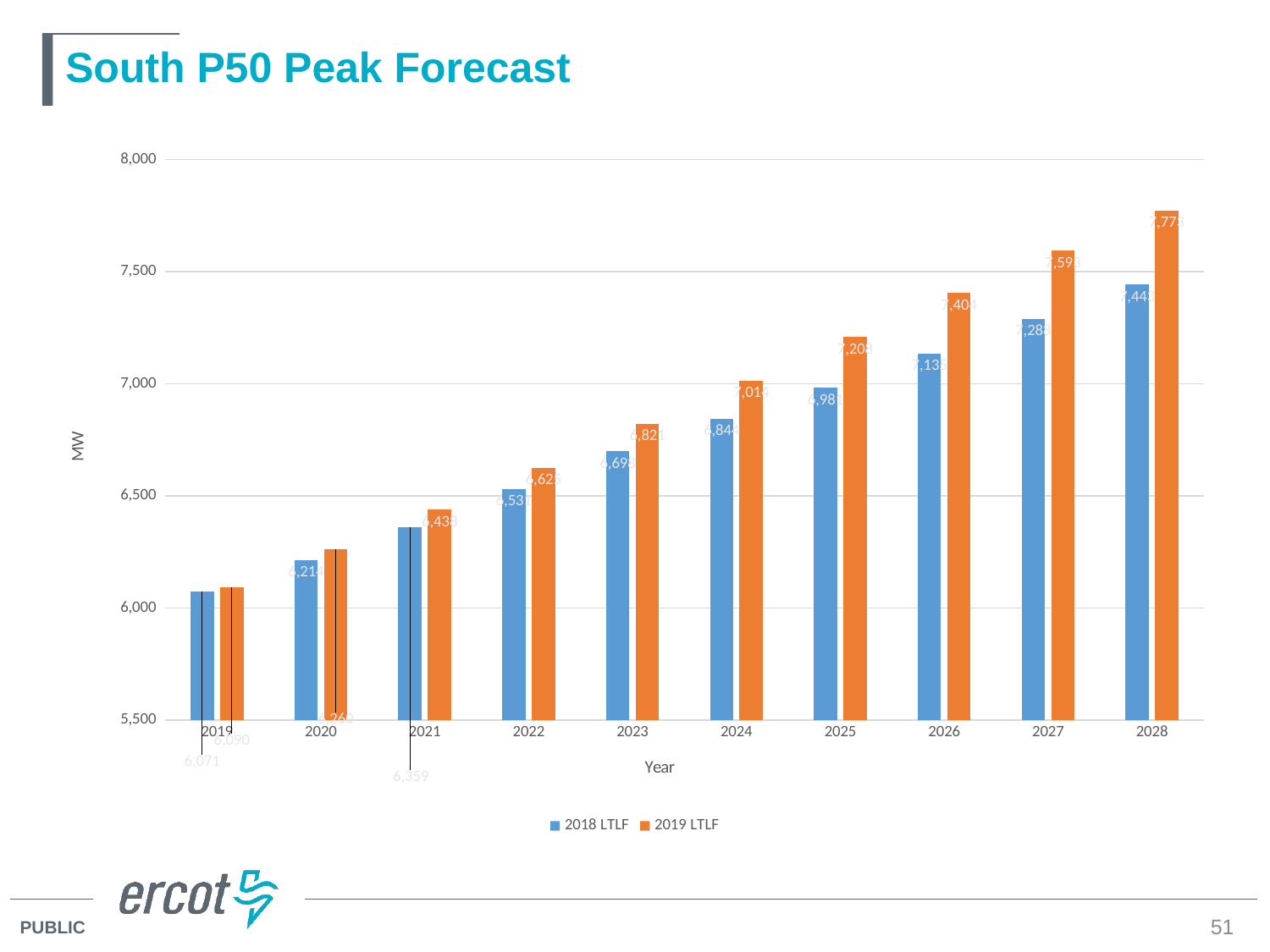
What is the 2019 LTLF value for 2019? 6,090 Do the 2019 LTLF values rise or fall from 2019 to 2028? rise How many years are shown on the x axis? 10 Which year has the lowest 2018 LTLF value? 2019 Is the 2018 LTLF value for 2024 greater or less than 7,000? less By how much does the 2019 LTLF value exceed the 2018 LTLF value in 2019? 19 What kind of chart is shown on the slide? bar chart Is the 2019 LTLF value for 2028 greater or less than 7,500? greater What is the 2018 LTLF value for 2021? 6,359 How many series does the legend list? 2 What is the 2018 LTLF value for 2019? 6,071 Which year has the highest 2019 LTLF value? 2028